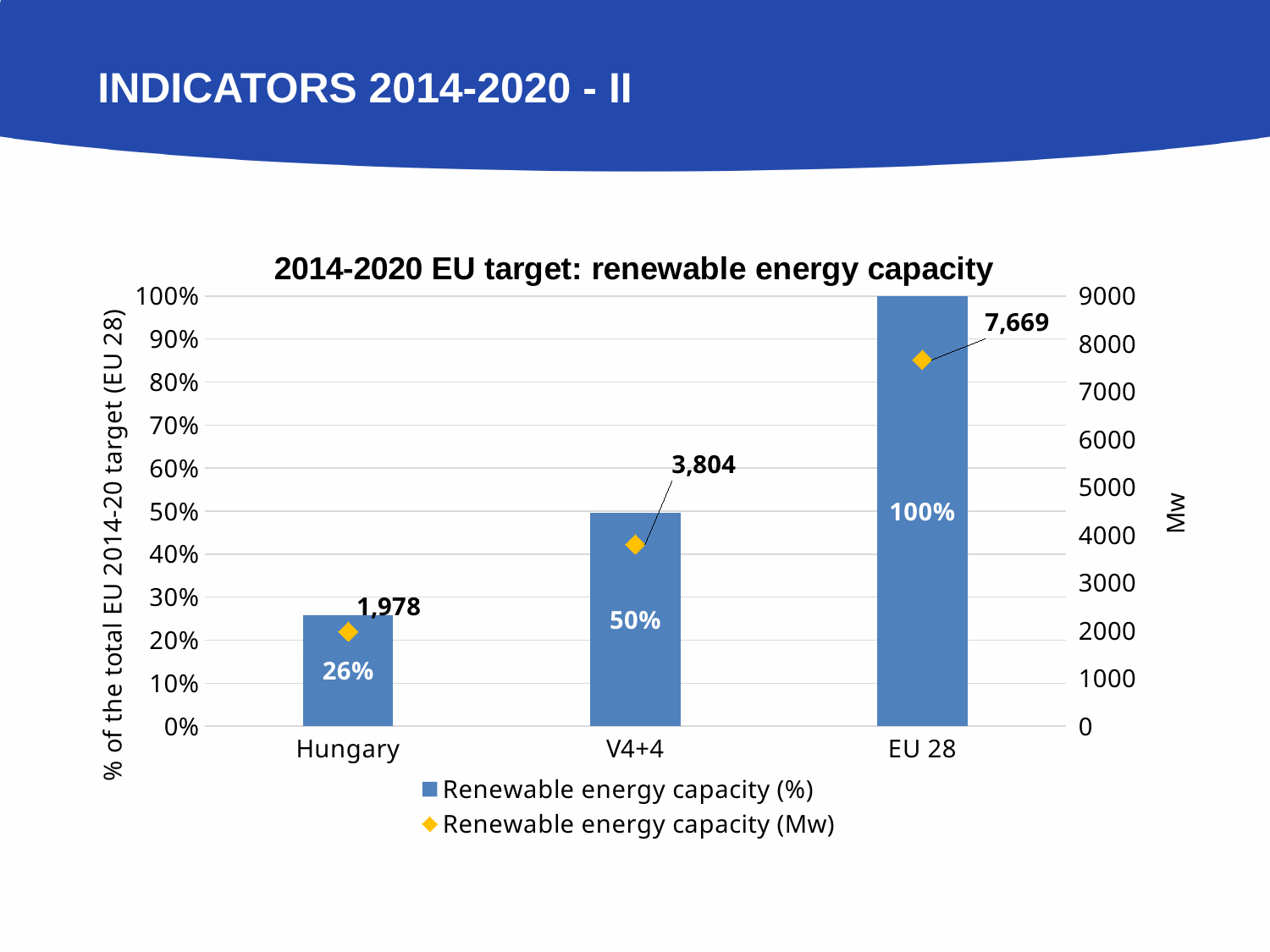
What is the renewable energy capacity (Mw) for V4+4? 3,804 How many series does the legend list? 2 Which category has the lowest renewable energy capacity (%)? Hungary Which has a larger renewable energy capacity (Mw), Hungary or V4+4? V4+4 What is the difference in renewable energy capacity (Mw) between EU 28 and V4+4? 3,865 What is the renewable energy capacity (Mw) for EU 28? 7,669 What is the renewable energy capacity (%) for V4+4? 50% What is the difference in renewable energy capacity (%) between V4+4 and Hungary? 24% What is the title of the chart? 2014-2020 EU target: renewable energy capacity What is the renewable energy capacity (%) for Hungary? 26% How many categories are shown on the x axis? 3 Which category has the highest renewable energy capacity (Mw)? EU 28